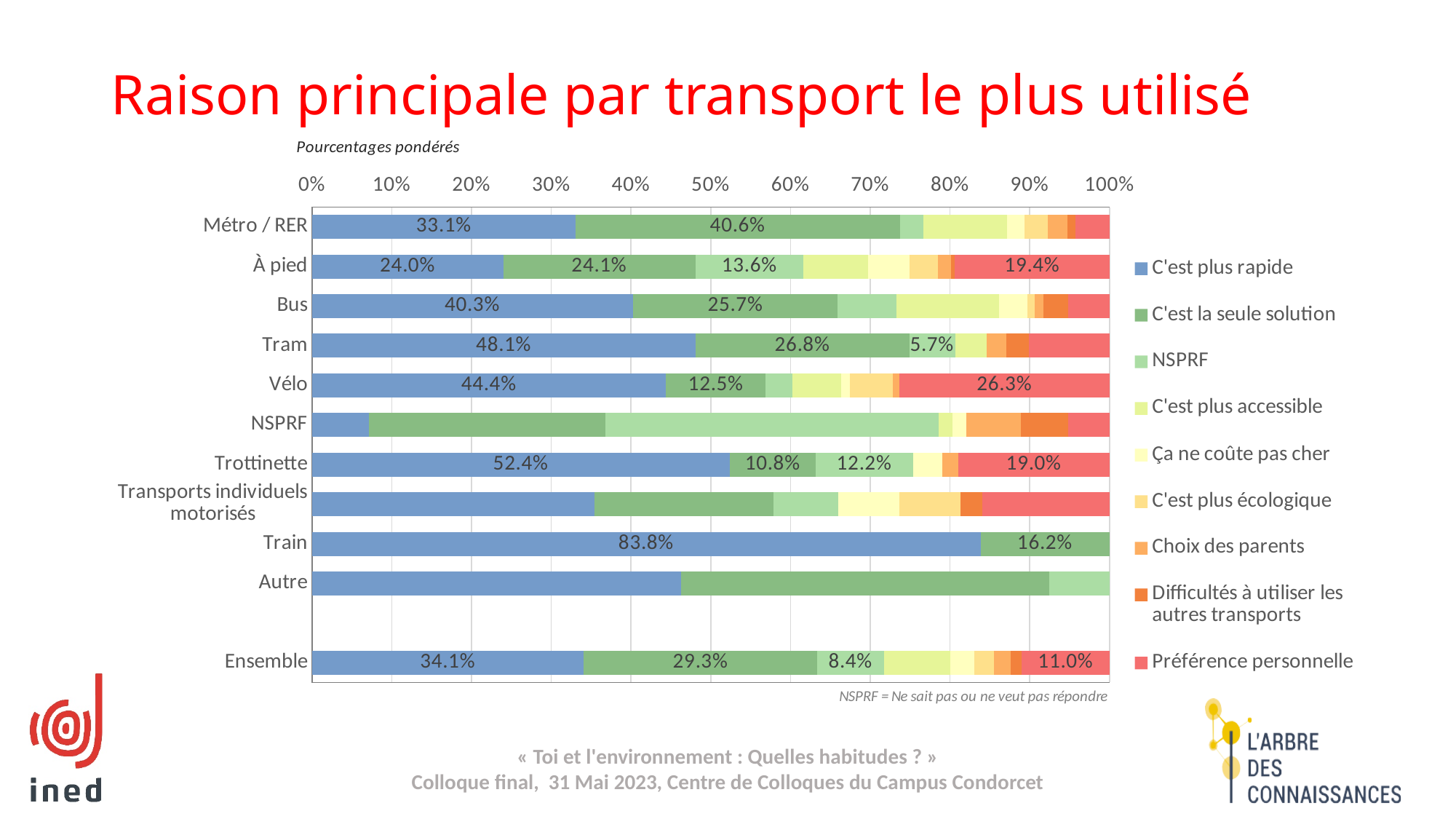
How many series does the legend list? 9 What is the title of the slide? Raison principale par transport le plus utilisé Is the "C'est plus rapide" value for NSPRF greater or less than 10%? less What kind of chart is shown on the slide? Stacked horizontal bar chart How many transport categories are shown on the chart? 11 For Tram, what is the difference between the "C'est plus rapide" value and the "C'est la seule solution" value? 21.3 percentage points Which has a larger "C'est plus rapide" value, Bus or Métro / RER? Bus In the Ensemble bar, what is the value for "C'est la seule solution"? 29.3% What is the "Préférence personnelle" value for Vélo? 26.3% What is the NSPRF value for Trottinette? 12.2% Which transport mode has the highest value for "C'est plus rapide"? Train What percentage of Train users give "C'est plus rapide" as their main reason? 83.8%